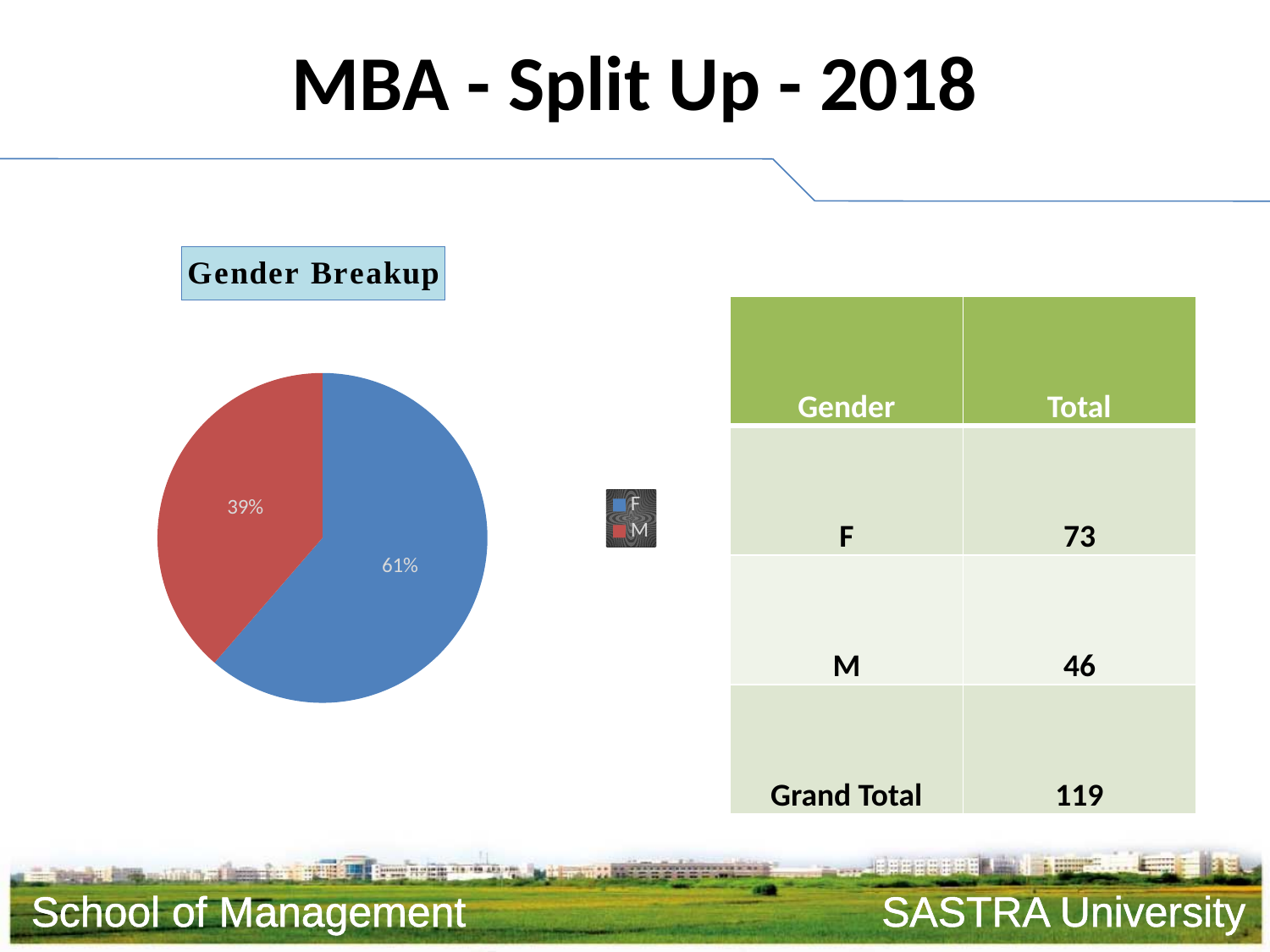
How many entries does the legend list? 2 What share of the pie does M represent? 39% Which slice is larger, F or M? F What is the title of the chart? Gender Breakup Which category has the smallest slice of the pie? M Which category has the largest slice of the pie? F How many slices does the pie chart have? 2 What is the difference in percentage points between the F slice and the M slice? 22 What kind of chart is shown on the slide? pie chart What colour is the M slice in the pie chart? red Is the share for F greater or less than 50%? greater What share of the pie does F represent? 61%